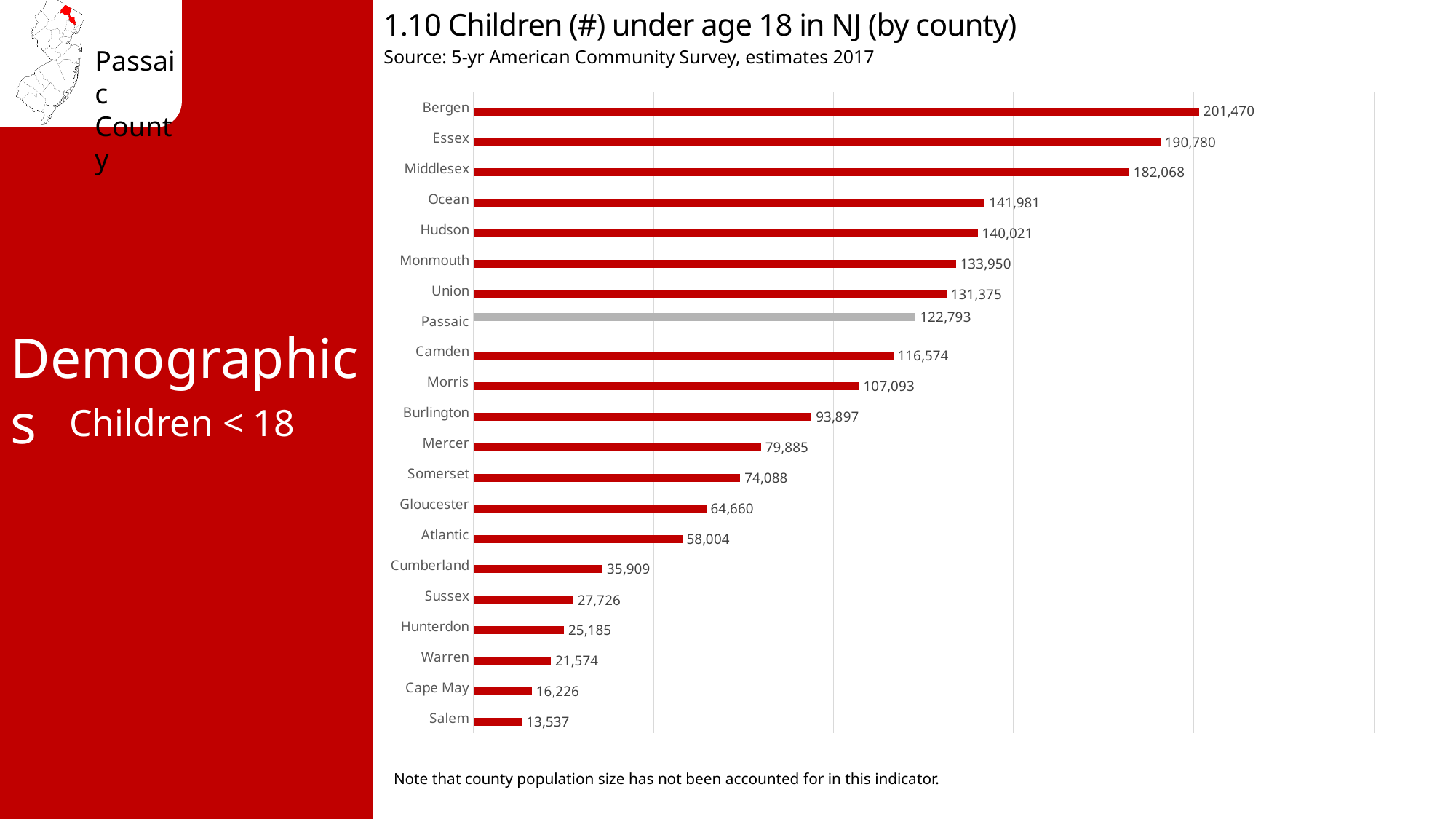
Which county has the lowest number of children under age 18? Salem What is the difference between the values for Passaic and Camden counties? 6,219 Which county has more children under age 18, Morris or Burlington? Morris Which county has more children under age 18, Sussex or Hunterdon? Sussex What is the difference between the values for Bergen and Essex counties? 10,690 Which county's bar is shown in grey instead of red? Passaic What is the number of children under age 18 in Passaic County? 122,793 What is the number of children under age 18 in Bergen County? 201,470 Which county has the highest number of children under age 18? Bergen What is the value shown for Salem County? 13,537 How many counties are shown in the chart? 21 What type of chart is shown on the slide? Bar chart